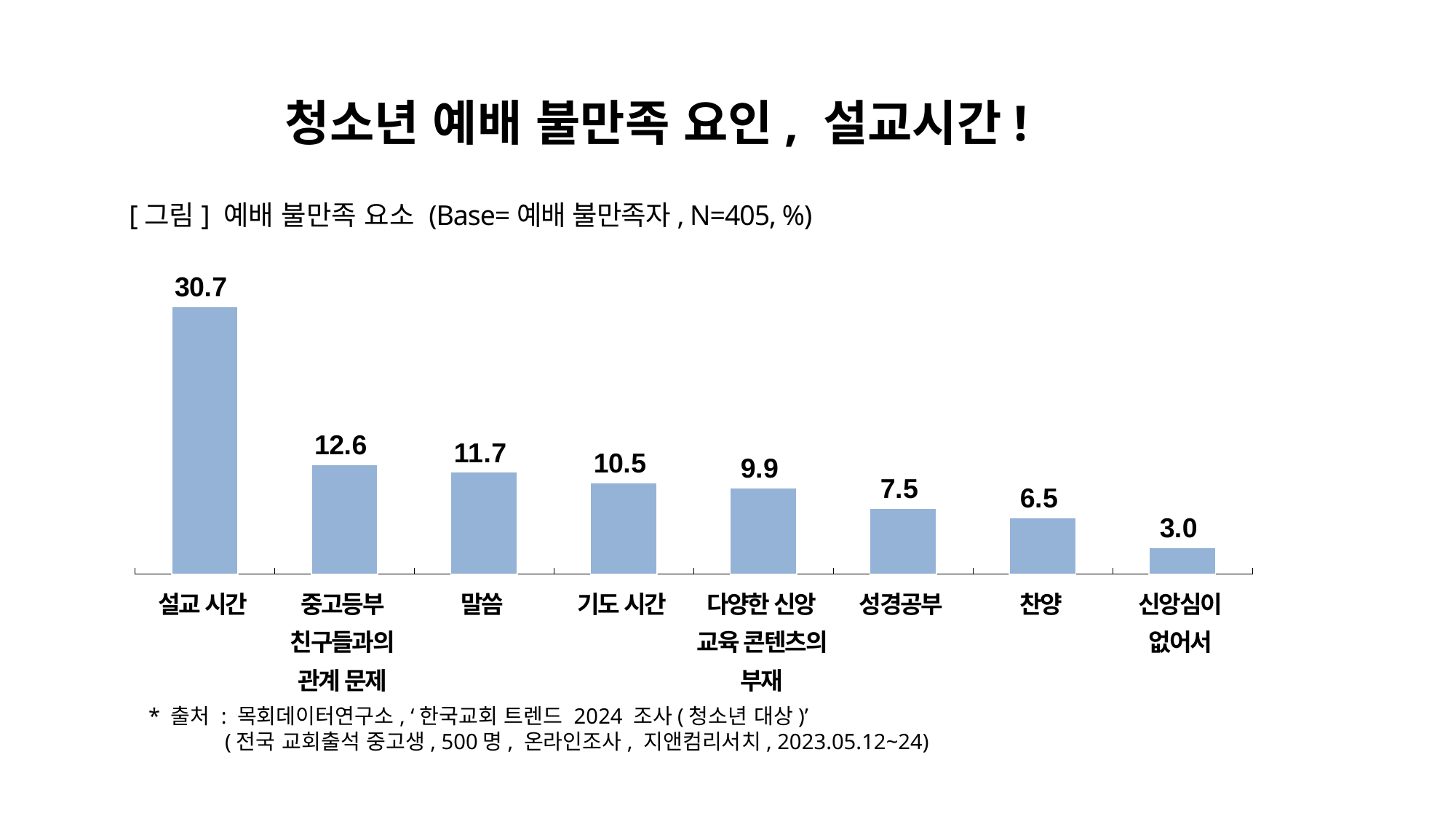
Which category has the highest value? 설교 시간 What is the value for 설교 시간? 30.7 What is the difference between the values for 설교 시간 and 중고등부 친구들과의 관계 문제? 18.1 Do the values rise or fall from left to right along the x axis? fall What is the value for 기도 시간? 10.5 Which is larger, the value for 말씀 or the value for 찬양? 말씀 What kind of chart is shown on the slide? bar chart How many categories are shown in the chart? 8 Which category has the lowest value? 신앙심이 없어서 What is the base size (N) stated in the chart caption? N=405 What is the value for 신앙심이 없어서? 3.0 What is the value for 성경공부? 7.5